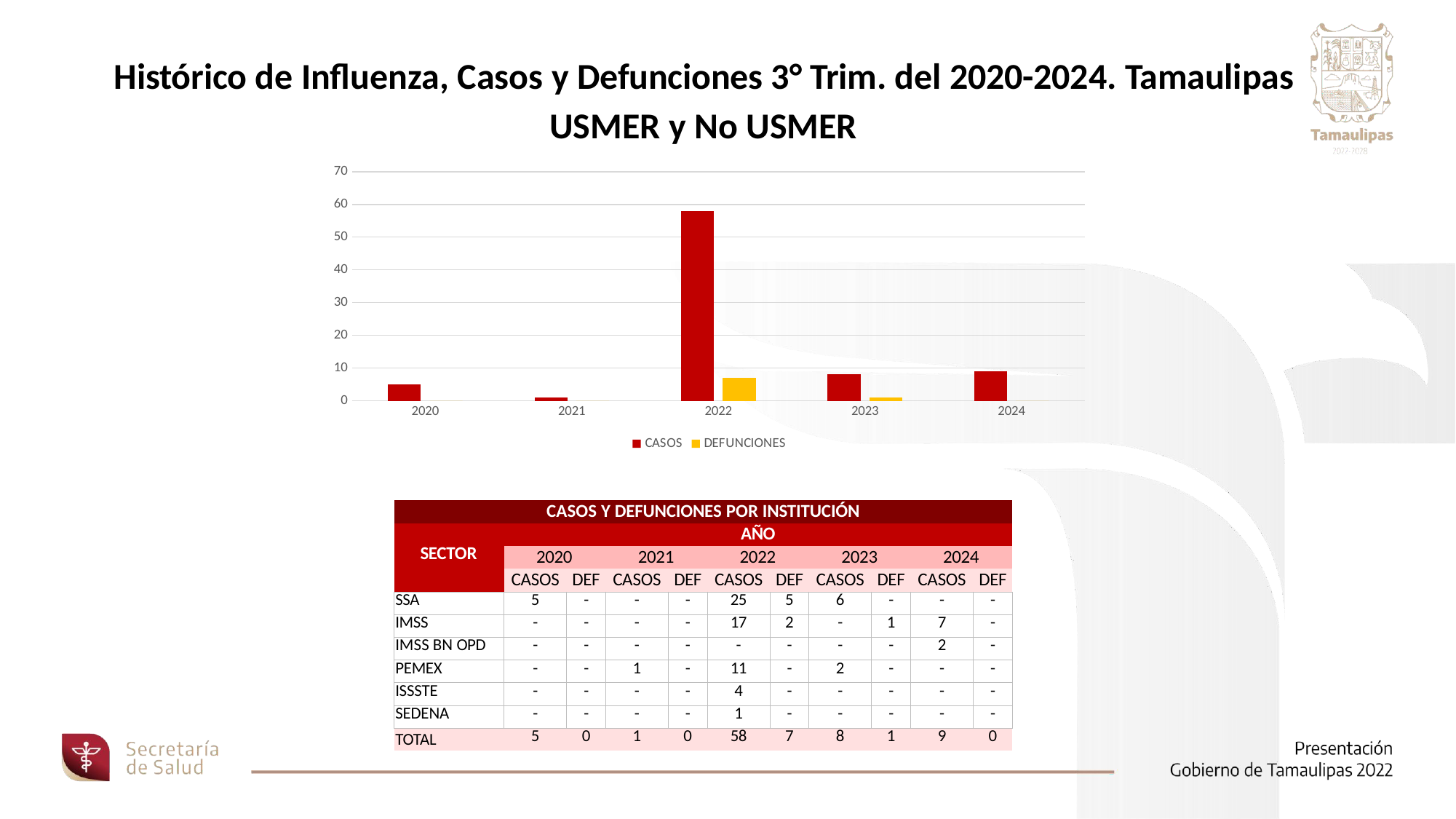
According to the TOTAL row of the table, what is the difference between CASOS in 2022 and CASOS in 2023? 50 Is the CASOS value for 2023 greater or less than 10? less Which year has the highest number of CASOS in the chart? 2022 Which year has the lowest number of CASOS in the chart? 2021 What kind of chart is shown on the slide? bar chart How many series does the chart legend list? 2 Which colour represents DEFUNCIONES in the chart legend? yellow How many years are shown on the x axis of the chart? 5 Is the CASOS value for 2022 greater or less than 50? greater According to the TOTAL row of the table, how many CASOS were there in 2022? 58 Which is larger in the chart: CASOS in 2024 or CASOS in 2020? CASOS in 2024 Is the DEFUNCIONES value for 2022 greater or less than 10? less